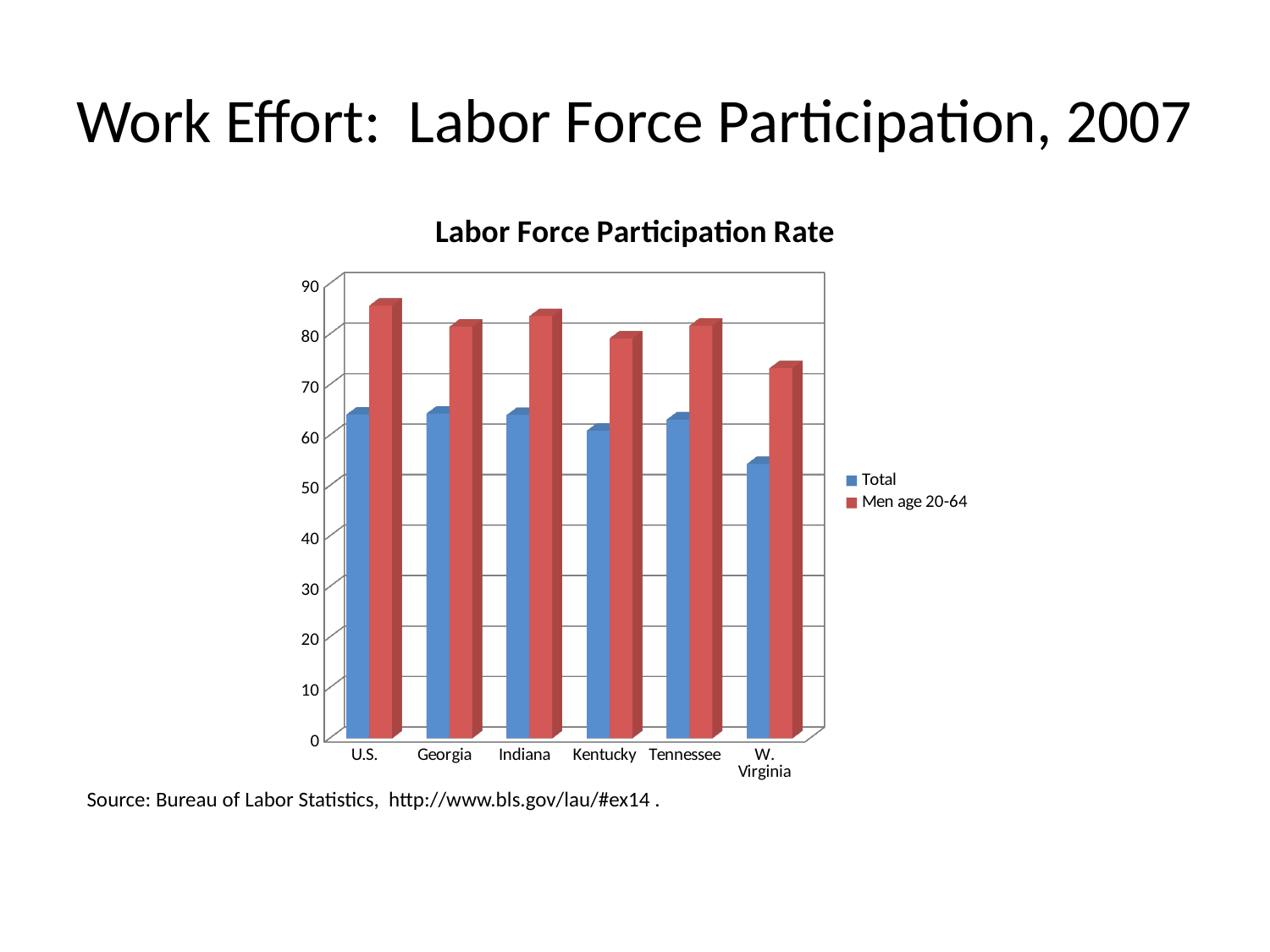
Is the Men age 20-64 value for W. Virginia greater or less than 70? greater For Kentucky, which is larger: the Total value or the Men age 20-64 value? Men age 20-64 Which is larger: the Total value for Kentucky or the Total value for W. Virginia? Kentucky Which category has the highest value for the Men age 20-64 series? U.S. Which category has the lowest value for the Men age 20-64 series? W. Virginia How many categories (states/regions) are shown on the x axis? 6 Which category has the lowest value for the Total series? W. Virginia Is the Total value for W. Virginia greater or less than 60? less What kind of chart is shown on the slide? bar chart What is the title of the chart? Labor Force Participation Rate Is the Men age 20-64 value for U.S. greater or less than 80? greater How many series does the legend list? 2